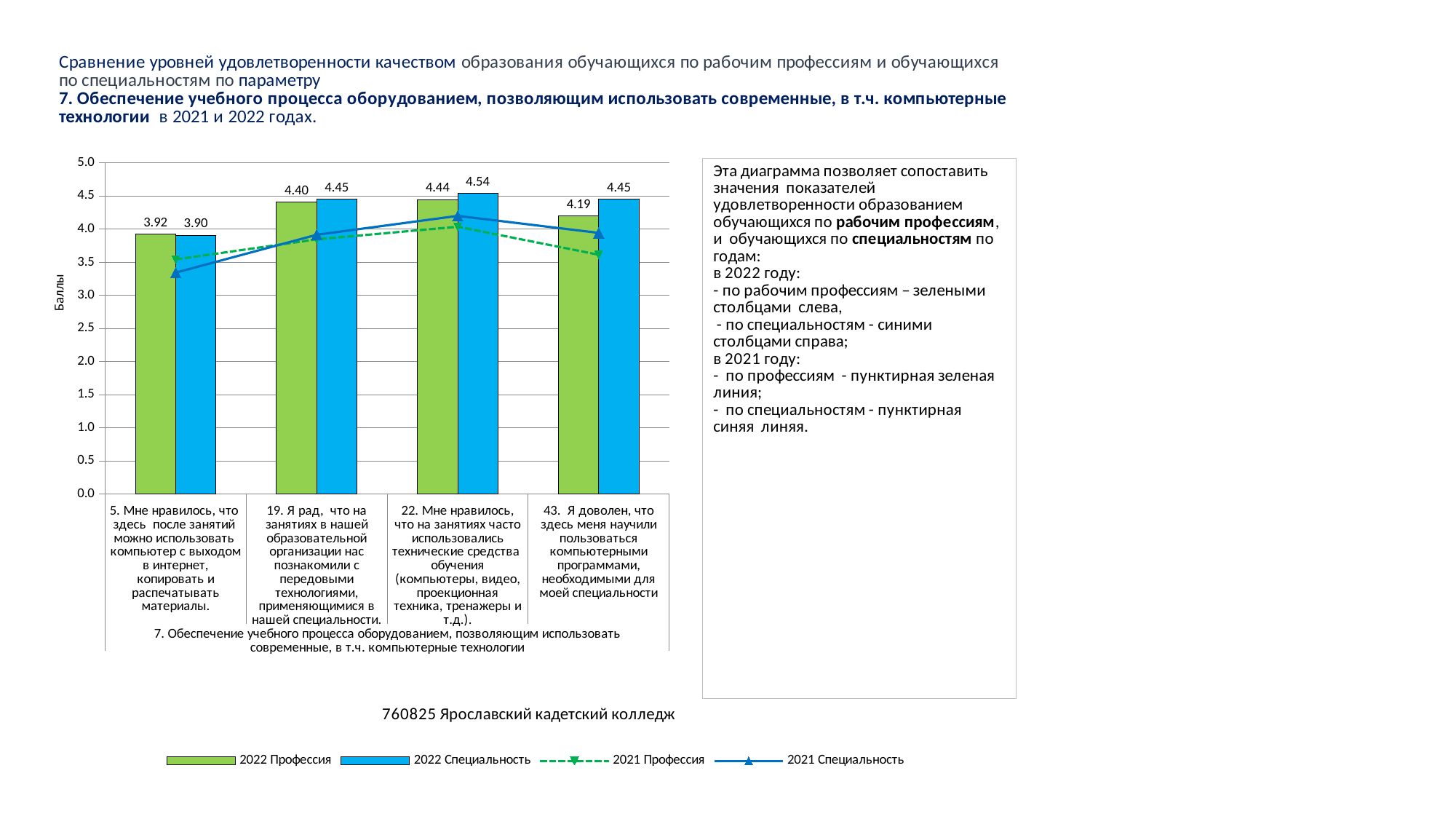
What kind of chart is shown on the slide? Combined bar and line chart What is the value of the 2022 Профессия bar for question 5 ("Мне нравилось, что здесь после занятий можно использовать компьютер...")? 3.92 Which question has the lowest 2022 Профессия bar? 5. Мне нравилось, что здесь после занятий можно использовать компьютер с выходом в интернет Is the 2021 Специальность line value for question 5 greater or less than 3.5? less For question 19, which 2022 bar is larger: Профессия or Специальность? Специальность Which question has the highest 2022 Специальность bar? 22. Мне нравилось, что на занятиях часто использовались технические средства обучения What is the value of the 2022 Профессия bar for question 43 ("Я доволен, что здесь меня научили пользоваться компьютерными программами...")? 4.19 What is the value of the 2022 Специальность bar for question 22 ("Мне нравилось, что на занятиях часто использовались технические средства обучения...")? 4.54 What is the label of the y axis? Баллы What is the difference between the 2022 Специальность and 2022 Профессия bars for question 43? 0.26 How many series does the legend list? 4 How many question categories are shown on the x axis? 4